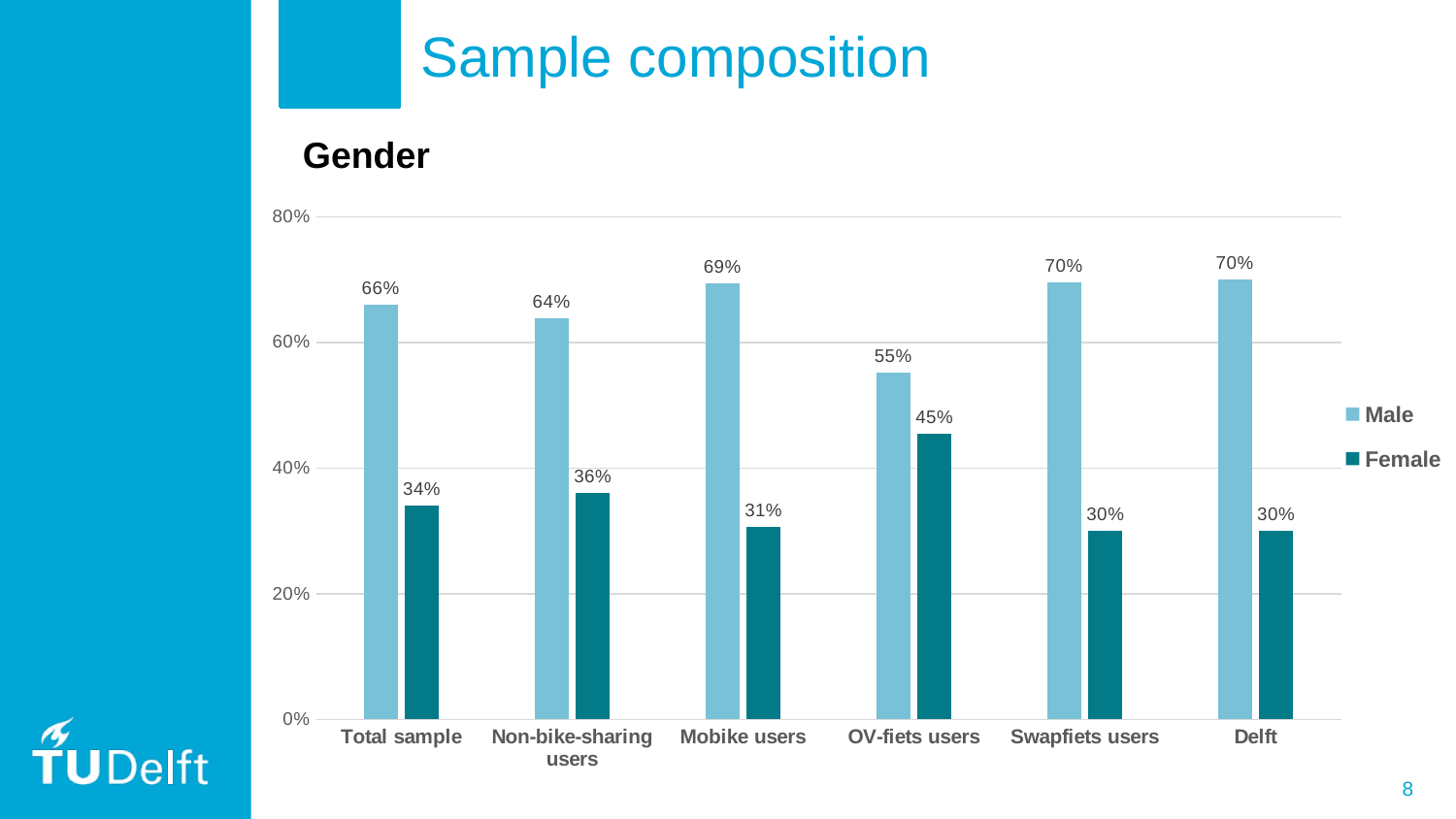
Which category has the highest Female value? OV-fiets users How many series does the legend list? 2 Is the Male value for OV-fiets users greater or less than 60%? less Which category has the lowest Male value? OV-fiets users Which is larger: the Female value for Mobike users or the Female value for Non-bike-sharing users? Non-bike-sharing users What is the Female value for OV-fiets users? 45% What is the difference between the Male and Female values for Non-bike-sharing users? 28% What is the Male value for Mobike users? 69% What is the Female value for the Total sample? 34% What kind of chart is shown on the slide? bar chart How many categories are shown on the x axis? 6 What is the title of the chart? Gender